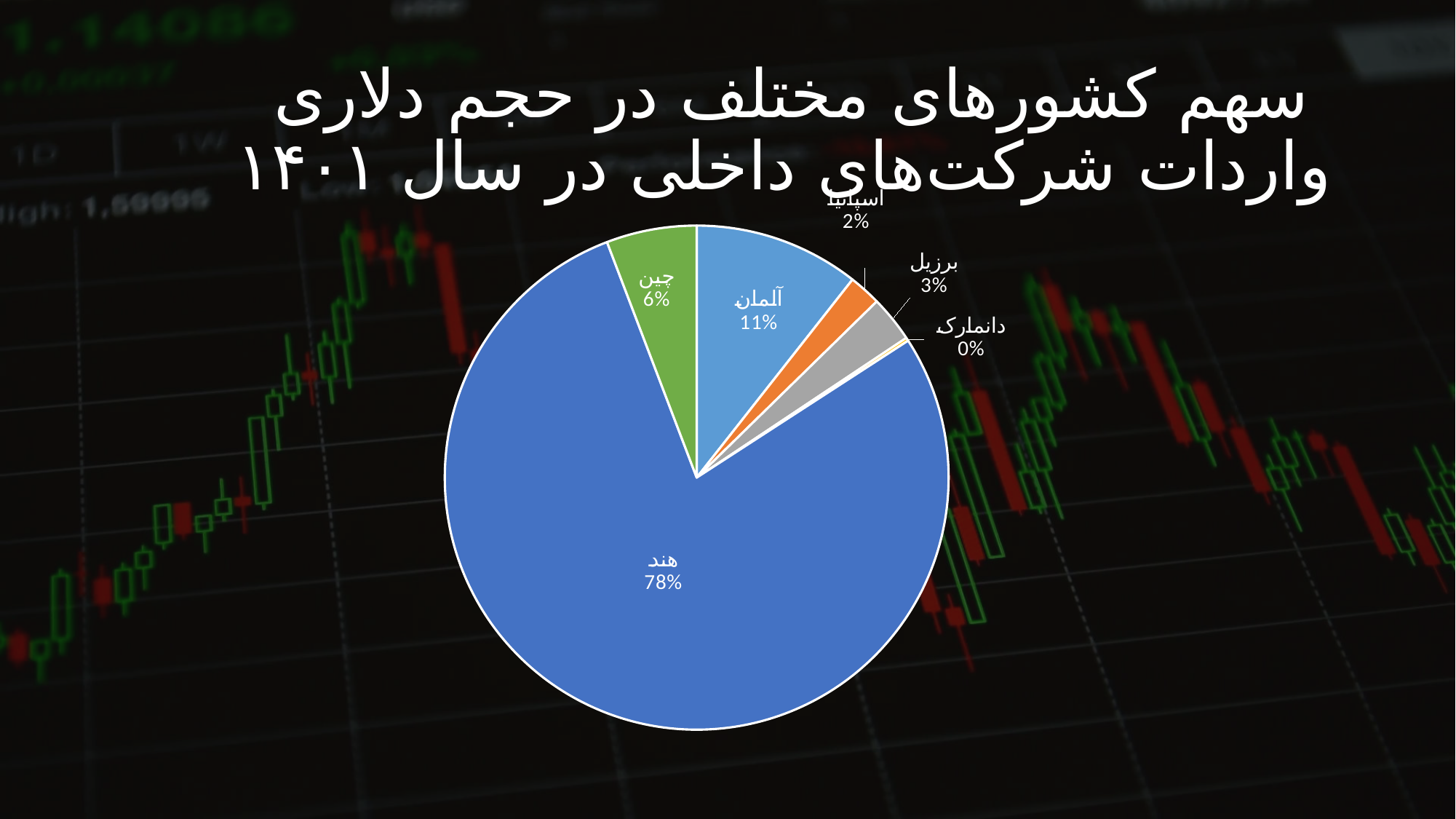
What kind of chart is shown on the slide? pie chart Which country has the largest slice of the pie? هند Which has a larger share, چین or برزیل? چین What share of the pie does آلمان (Germany) hold? 11% What share of the pie does اسپانیا (Spain) hold? 2% What is the difference in percentage points between the shares of هند and آلمان? 67% How many countries (slices) are shown in the pie chart? 6 What share of the pie does دانمارک (Denmark) hold? 0% Which country has the smallest slice of the pie? دانمارک